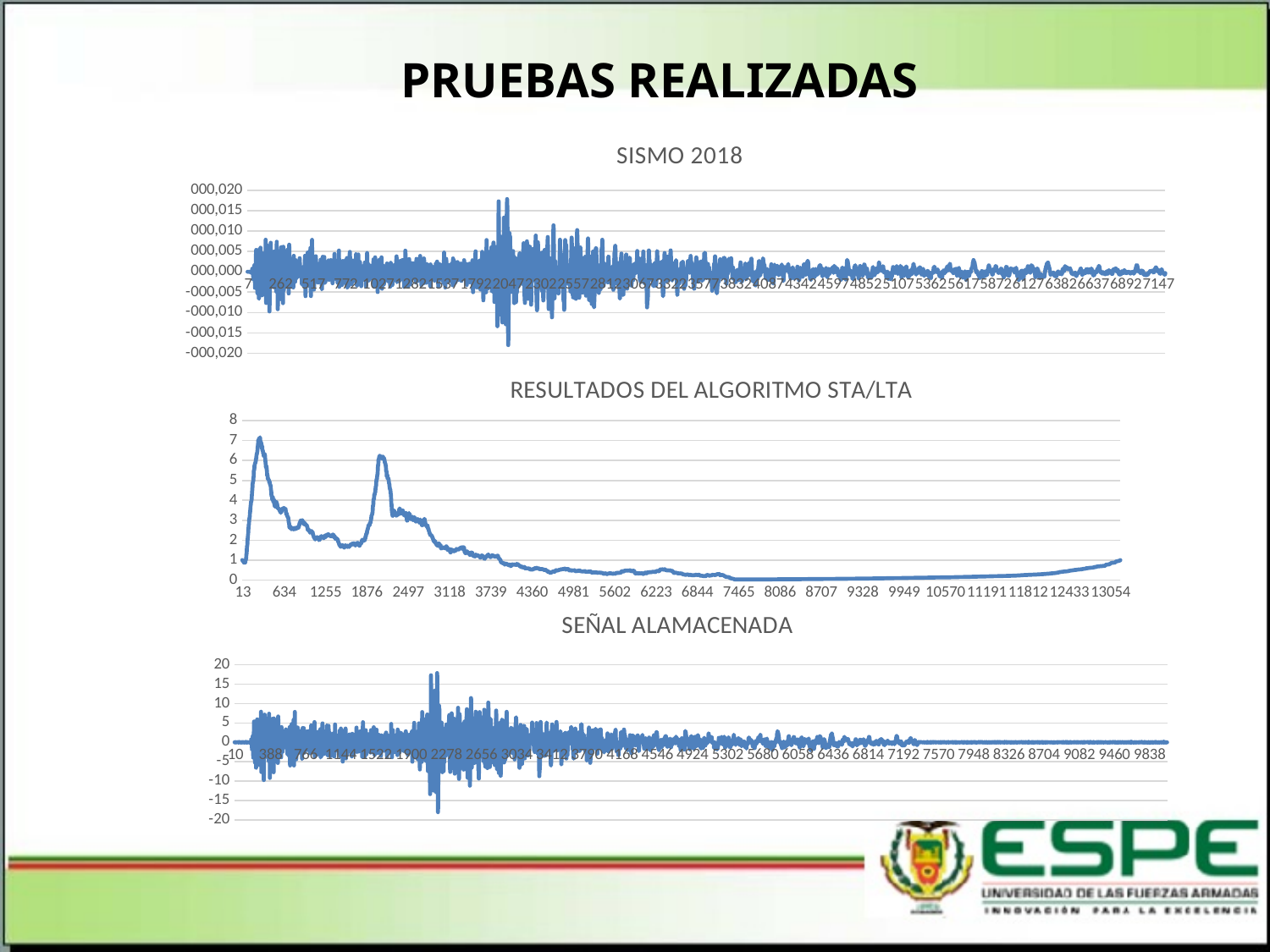
What is the title of the bottom chart on the slide? SEÑAL ALAMACENADA In the RESULTADOS DEL ALGORITMO STA/LTA chart, which is higher: the first peak (near x = 634) or the second peak (near x = 2497)? The first peak In the RESULTADOS DEL ALGORITMO STA/LTA chart, is the highest value of the line greater or less than 6? greater In the SEÑAL ALAMACENADA chart, is the highest value of the line greater or less than 15? greater In the RESULTADOS DEL ALGORITMO STA/LTA chart, is the value at the right end of the line (around x = 13054) greater or less than 2? less In the RESULTADOS DEL ALGORITMO STA/LTA chart, does the line rise or fall between x = 2497 and x = 4981? Fall What is the title of the middle chart on the slide? RESULTADOS DEL ALGORITMO STA/LTA What kind of chart is the SISMO 2018 chart? Line chart What kind of chart is the SEÑAL ALAMACENADA chart? Line chart In the RESULTADOS DEL ALGORITMO STA/LTA chart, does the line rise or fall between x = 11812 and x = 13054? Rise